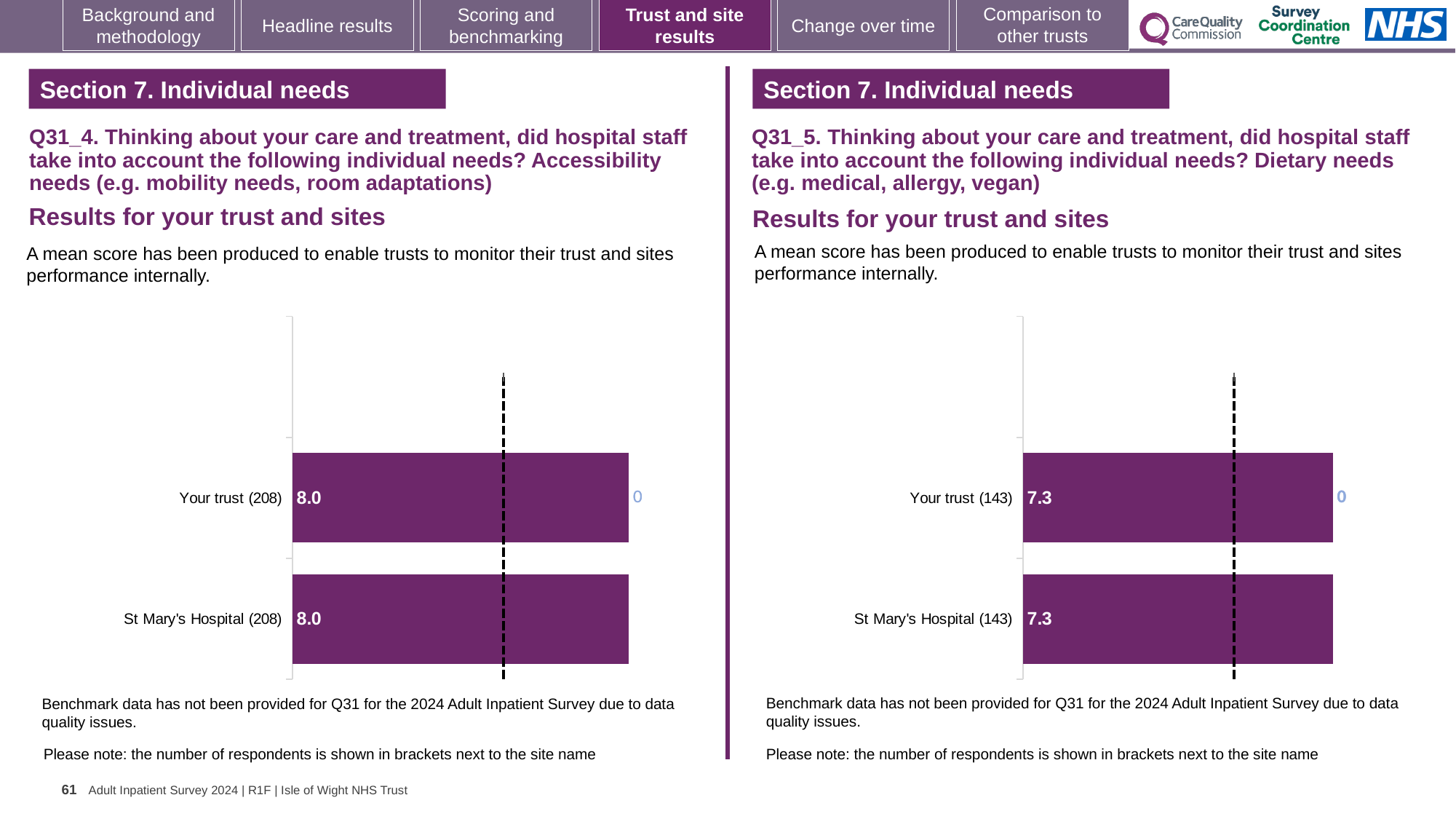
How many bars are plotted in the left chart (Q31_4)? 2 In the right chart (Q31_5, dietary needs), what is the mean score for Your trust? 7.3 How many bars are plotted in the right chart (Q31_5)? 2 In the right chart (Q31_5, dietary needs), what is the mean score for St Mary's Hospital? 7.3 In the left chart (Q31_4, accessibility needs), what is the mean score for St Mary's Hospital? 8.0 What type of chart is used in the left chart (Q31_4)? Bar chart What type of chart is used in the right chart (Q31_5)? Bar chart In the left chart (Q31_4, accessibility needs), what is the mean score for Your trust? 8.0 In the left chart (Q31_4), what is the difference between the scores for Your trust and St Mary's Hospital? 0.0 In the right chart (Q31_5), how many respondents are shown in brackets next to St Mary's Hospital? 143 In the left chart (Q31_4), how many respondents are shown in brackets next to Your trust? 208 In the right chart (Q31_5), what is the difference between the scores for Your trust and St Mary's Hospital? 0.0